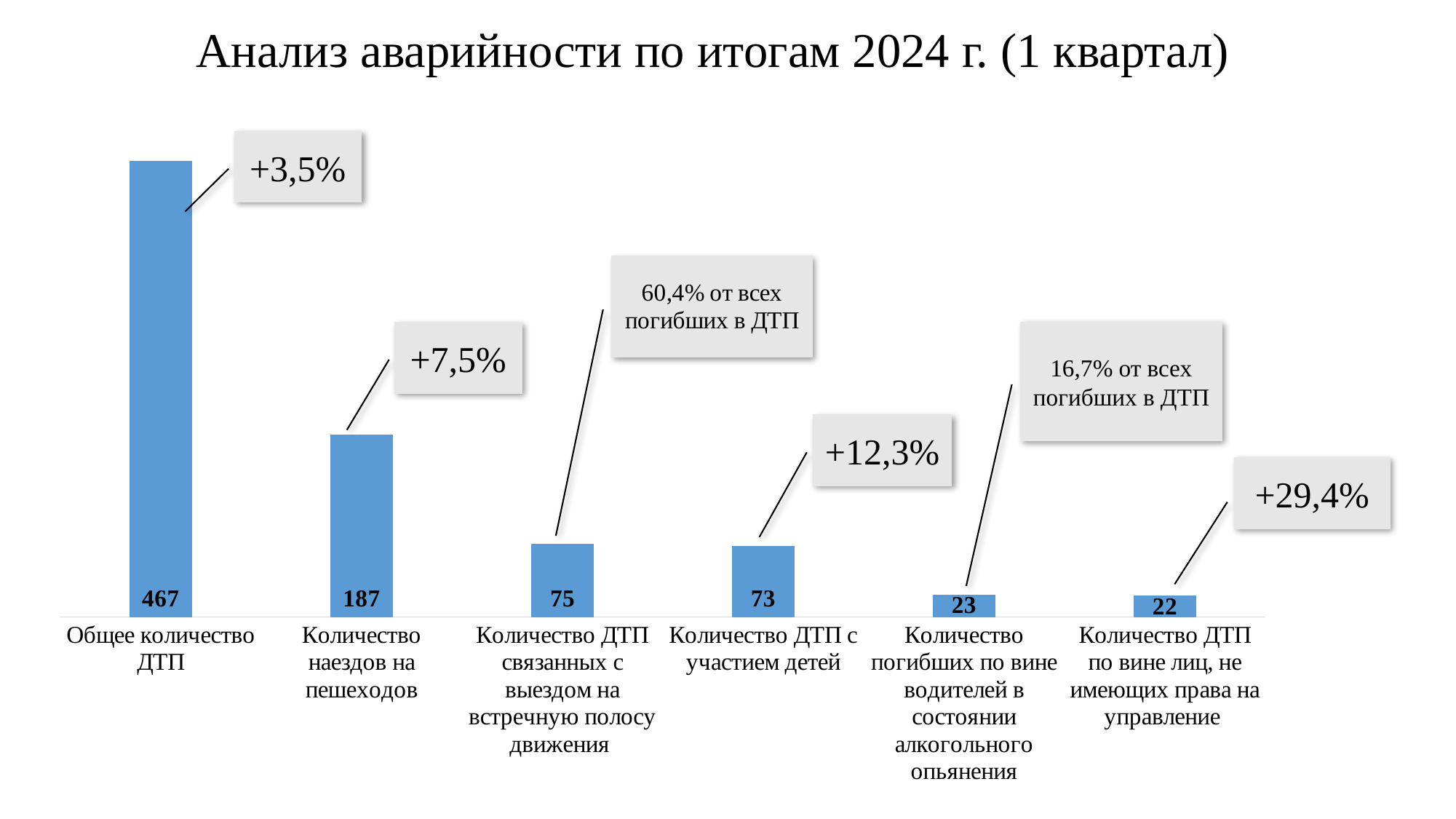
How many categories are shown in the chart? 6 What is the difference between "Количество ДТП связанных с выездом на встречную полосу движения" and "Количество ДТП с участием детей"? 2 Which is larger: "Количество наездов на пешеходов" or "Количество ДТП с участием детей"? Количество наездов на пешеходов What is the value for "Количество ДТП с участием детей"? 73 What is the value for "Общее количество ДТП"? 467 What is the value for "Количество наездов на пешеходов"? 187 What is the difference between "Общее количество ДТП" and "Количество наездов на пешеходов"? 280 What percentage change is shown in the callout for "Количество ДТП по вине лиц, не имеющих права на управление"? +29,4% What kind of chart is shown on the slide? Bar chart Which category has the lowest value? Количество ДТП по вине лиц, не имеющих права на управление What is the value for "Количество ДТП по вине лиц, не имеющих права на управление"? 22 Which category has the highest value? Общее количество ДТП